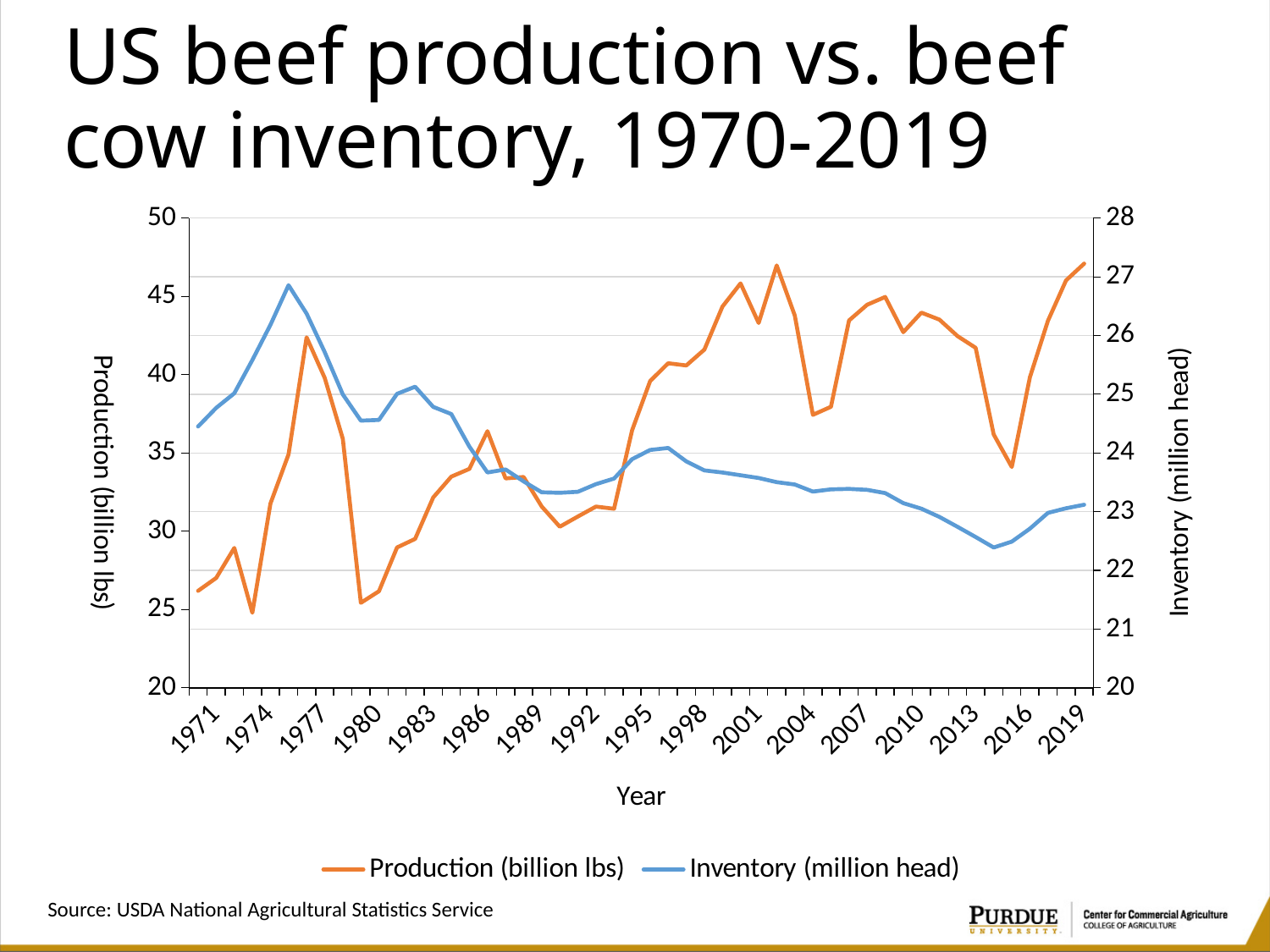
Is the value for Production (billion lbs) in 1979 greater or less than 30? less Is the value for Inventory (million head) in 1975 greater or less than 26? greater What is the label of the right-hand vertical axis? Inventory (million head) Does the Production (billion lbs) series rise or fall between 1990 and 2000? rise How many series does the legend list? 2 Is the value for Inventory (million head) in 2014 greater or less than 23? less In which year does the Inventory (million head) series reach its lowest value? 2014 What kind of chart is shown on the slide? Line chart Does the Inventory (million head) series rise or fall between 1996 and 2014? fall In which year does the Inventory (million head) series reach its highest value? 1975